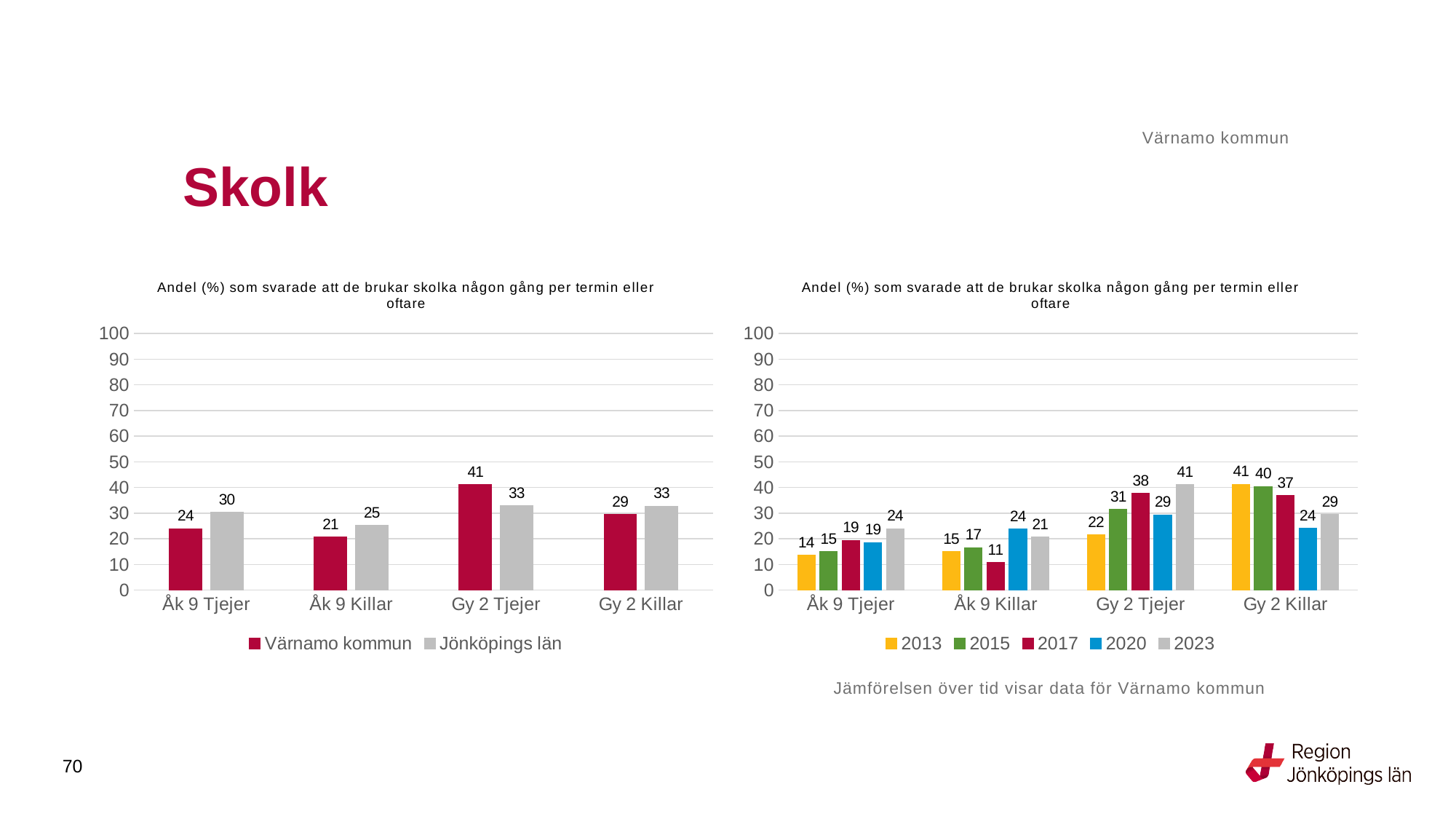
In the right chart, how many series does the legend list? 5 In the right chart, what is the difference between 2013 and 2023 for Gy 2 Killar? 12 What kind of chart is the right chart? Bar chart In the left chart, which is larger for Åk 9 Tjejer: Värnamo kommun or Jönköpings län? Jönköpings län In the right chart, what is the value for 2023 for Gy 2 Tjejer? 41 In the left chart, how many series does the legend list? 2 In the left chart, what is the value for Jönköpings län for Åk 9 Killar? 25 In the left chart, what is the value for Värnamo kommun for Gy 2 Tjejer? 41 In the left chart, which category has the highest value for Värnamo kommun? Gy 2 Tjejer In the right chart, what is the value for 2020 for Åk 9 Killar? 24 In the left chart, what is the difference between Värnamo kommun and Jönköpings län for Gy 2 Tjejer? 8 In the right chart, which year has the lowest value for Åk 9 Killar? 2017